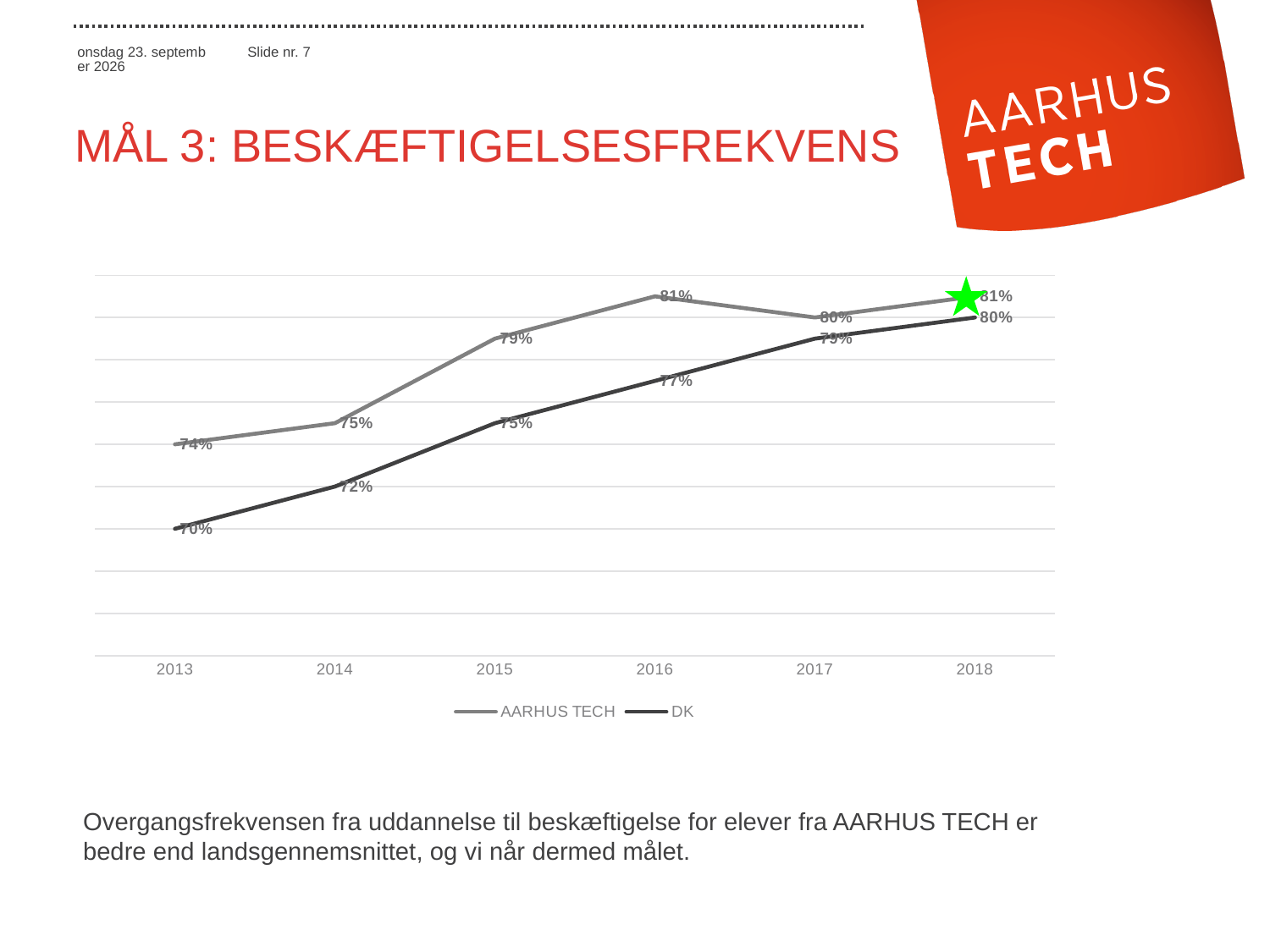
What is the value for DK in 2016? 77% In which year is the DK value lowest? 2013 What is the value for AARHUS TECH in 2013? 74% Does the DK series rise or fall from 2013 to 2018? rise What is the value for AARHUS TECH in 2015? 79% How many years are shown on the x axis? 6 How many series does the legend list? 2 What kind of chart is shown on the slide? line chart What is the difference between AARHUS TECH and DK in 2013? 4% What is the value for DK in 2018? 80% Which series has the higher value in 2015, AARHUS TECH or DK? AARHUS TECH Which series is drawn with the darker (black) line? DK